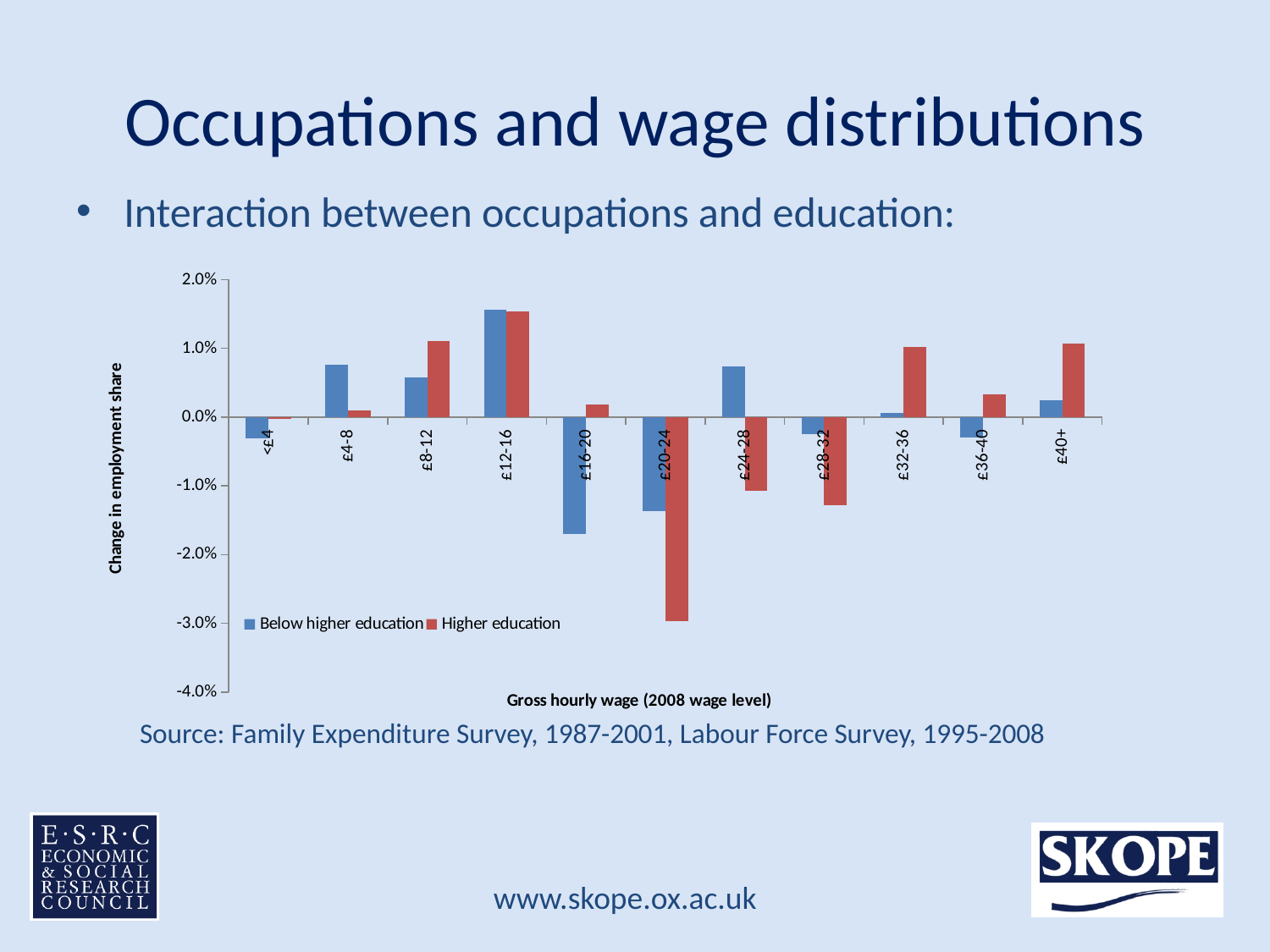
What is the title of the x axis? Gross hourly wage (2008 wage level) Is the Below higher education value for £12-16 greater or less than 1.0%? greater Is the Below higher education value for £16-20 greater or less than -1.0%? less What kind of chart is shown on the slide? bar chart Which wage category has the lowest Below higher education value? £16-20 How many series does the legend list? 2 Is the Higher education value for £8-12 greater or less than 1.0%? greater How many wage categories are shown on the x axis? 11 Which wage category has the highest Below higher education value? £12-16 For the £8-12 category, which series has the larger value, Below higher education or Higher education? Higher education Which wage category has the lowest Higher education value? £20-24